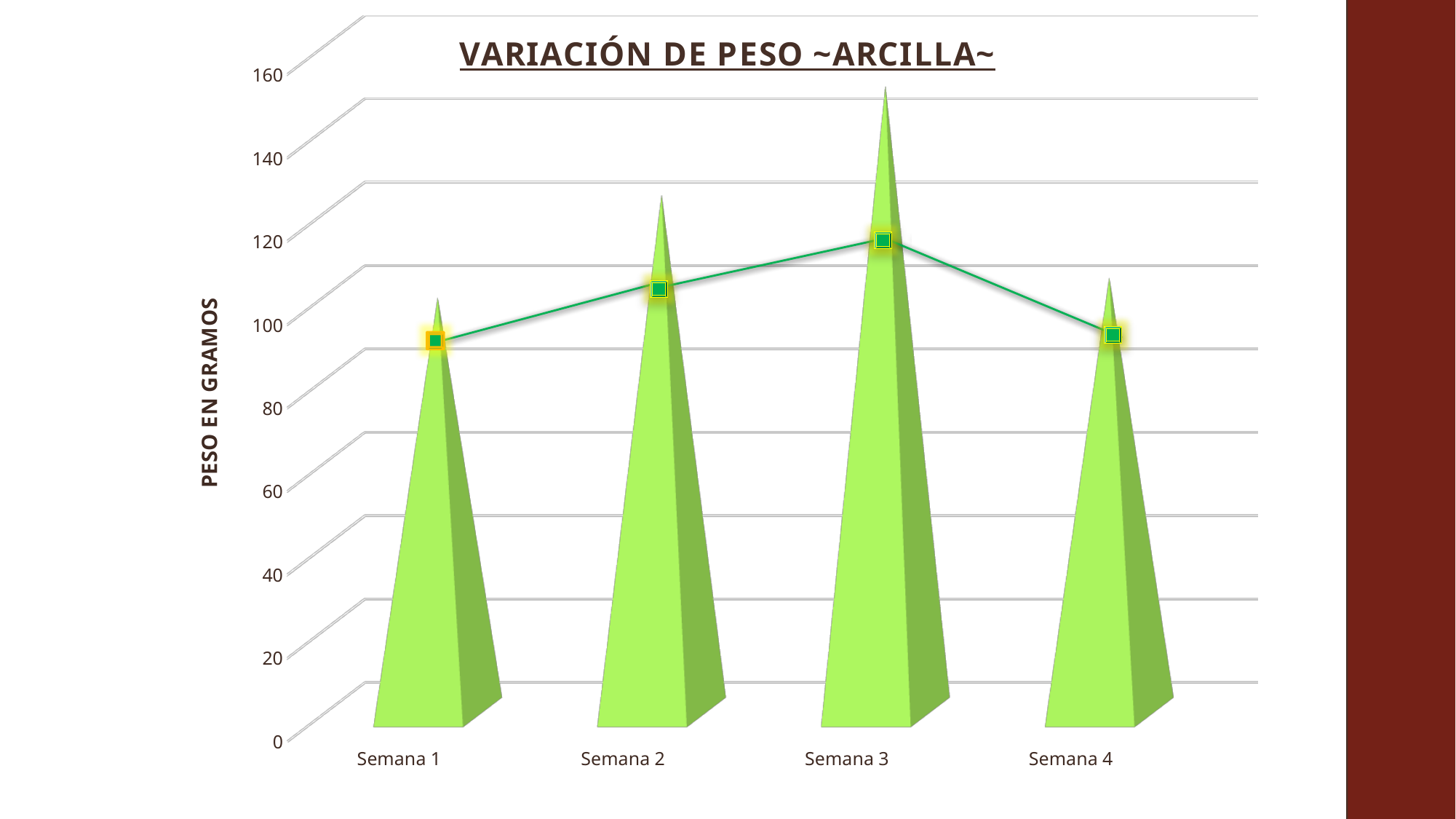
What is the label on the vertical axis of the chart? PESO EN GRAMOS Which is larger, the value for Semana 2 or the value for Semana 3? Semana 3 Is the value for Semana 1 greater or less than 120? less Which is larger, the value for Semana 1 or the value for Semana 2? Semana 2 Is the value for Semana 2 greater or less than 100? greater How many categories (weeks) are shown on the x axis? 4 How do the values change from Semana 1 to Semana 4? They rise through Semana 3, then fall at Semana 4 Is the value for Semana 3 greater or less than 140? greater What kind of chart is shown on the slide? bar chart What is the title of the chart? VARIACIÓN DE PESO ~ARCILLA~ Which week has the highest value? Semana 3